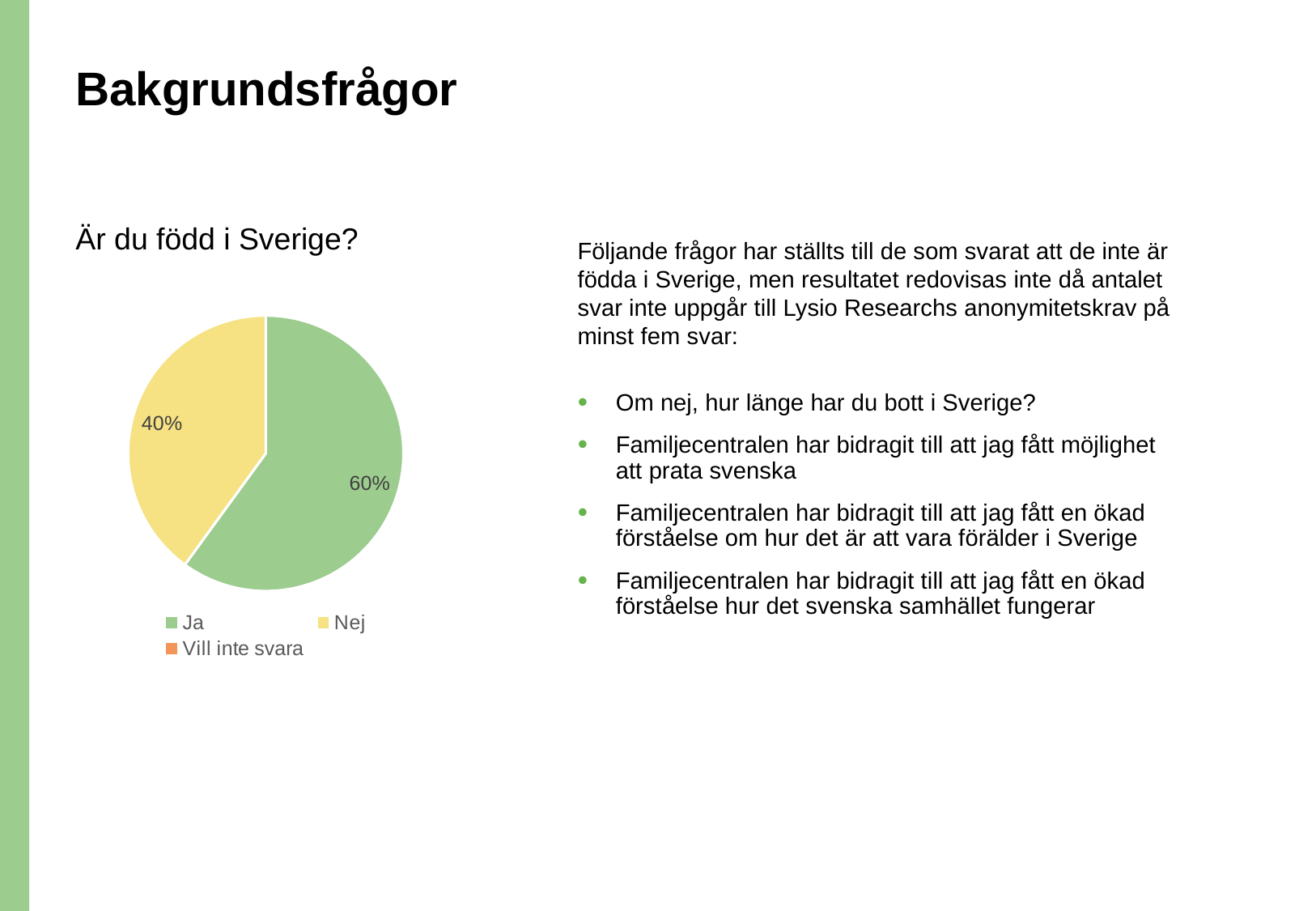
What is the title of the chart? Är du född i Sverige? What share of the pie is labelled "Nej"? 40% What share of the pie is labelled "Ja"? 60% What colour is the "Nej" slice of the pie? Yellow What is the difference in percentage points between the "Ja" and "Nej" slices? 20 percentage points How many entries does the legend list? 3 Which is larger, the "Ja" slice or the "Nej" slice? Ja How many slices with data labels are visible in the pie? 2 Which slice of the pie is the largest? Ja Which of the two visible slices is the smallest? Nej What kind of chart is shown on the slide? Pie chart